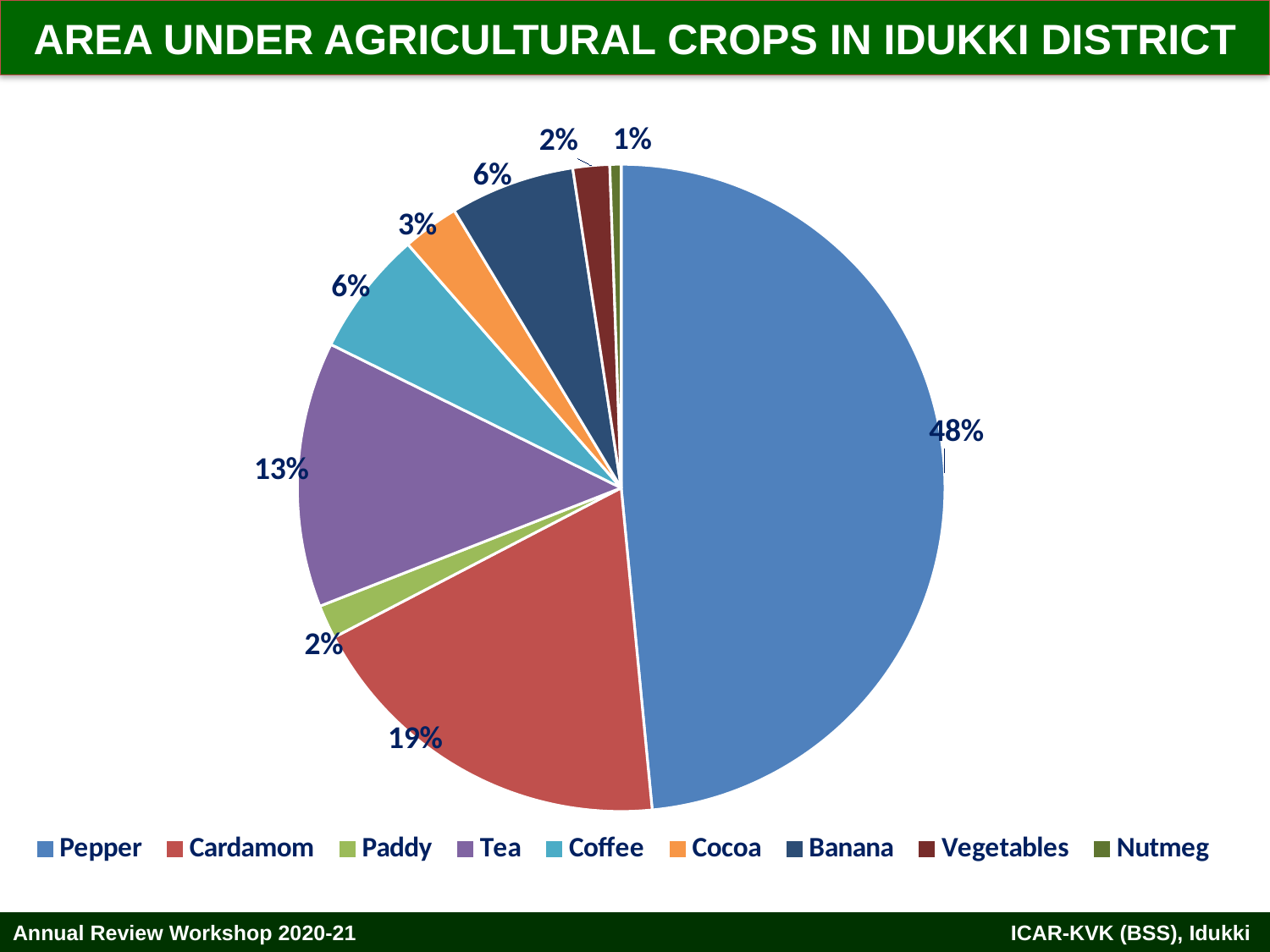
What type of chart is shown on the slide? Pie chart What share of the area is Tea? 13% Which has a larger share, Tea or Coffee? Tea Which crop has the smallest share of the area? Nutmeg Which crop has the largest share of the area? Pepper What is the title of the chart? AREA UNDER AGRICULTURAL CROPS IN IDUKKI DISTRICT How many crops are shown in the pie chart? 9 What share of the area is Cardamom? 19% What share of the area under agricultural crops is Pepper? 48% What colour is the Cardamom slice? Red What is the difference in percentage points between the Pepper and Cardamom shares? 29